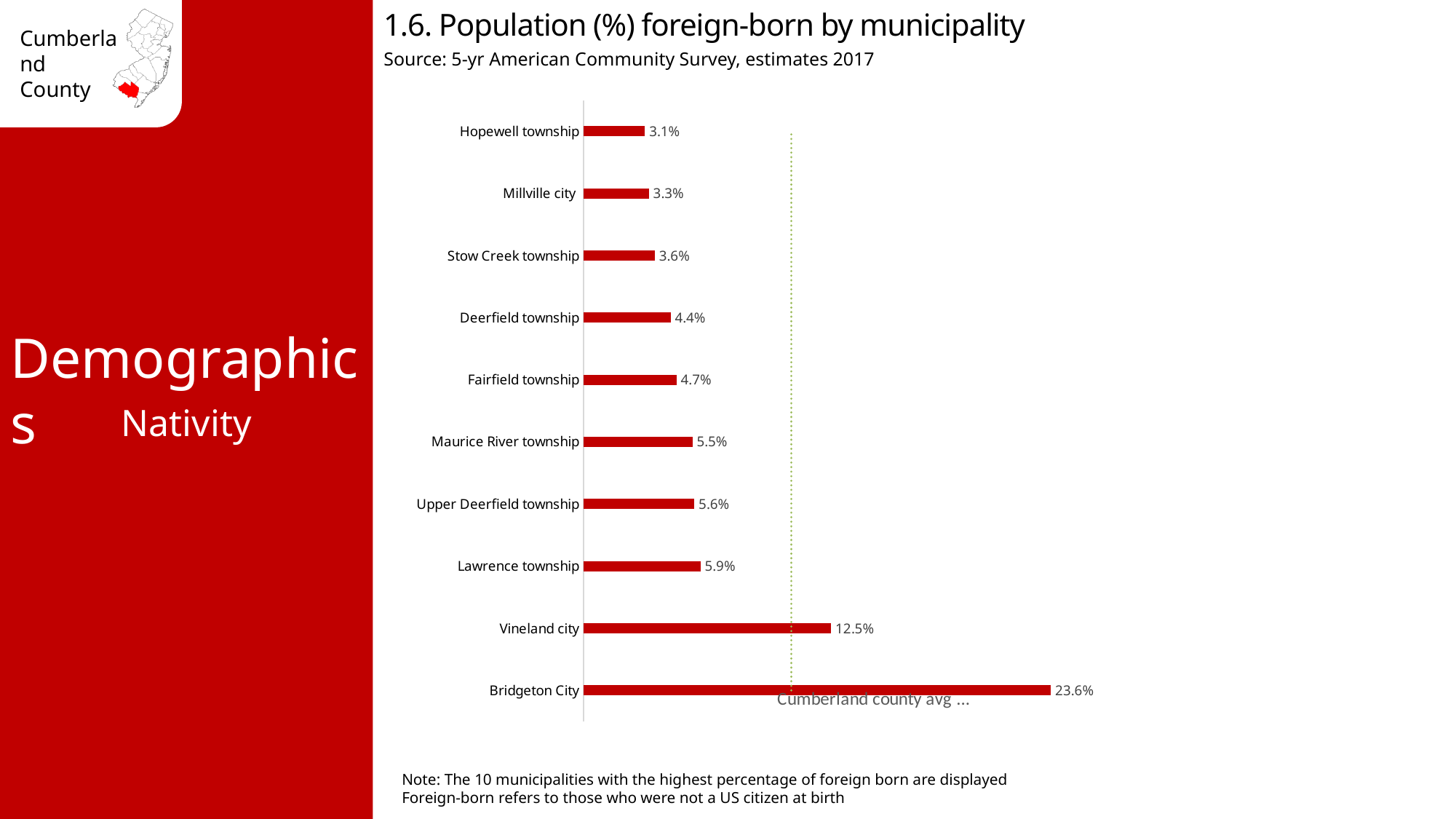
How many municipalities are shown in the chart? 10 What is the percentage of foreign-born population in Hopewell township? 3.1% Which has a higher foreign-born percentage, Deerfield township or Upper Deerfield township? Upper Deerfield township What is the percentage of foreign-born population in Maurice River township? 5.5% What is the percentage of foreign-born population in Bridgeton City? 23.6% Which municipality has the lowest percentage of foreign-born population? Hopewell township What is the difference in foreign-born percentage between Bridgeton City and Vineland city? 11.1% What type of chart is used to show the foreign-born population by municipality? Bar chart What is the difference in foreign-born percentage between Lawrence township and Millville city? 2.6% Which municipality has the highest percentage of foreign-born population? Bridgeton City What is the source of the data shown in the chart? 5-yr American Community Survey, estimates 2017 What is the percentage of foreign-born population in Vineland city? 12.5%